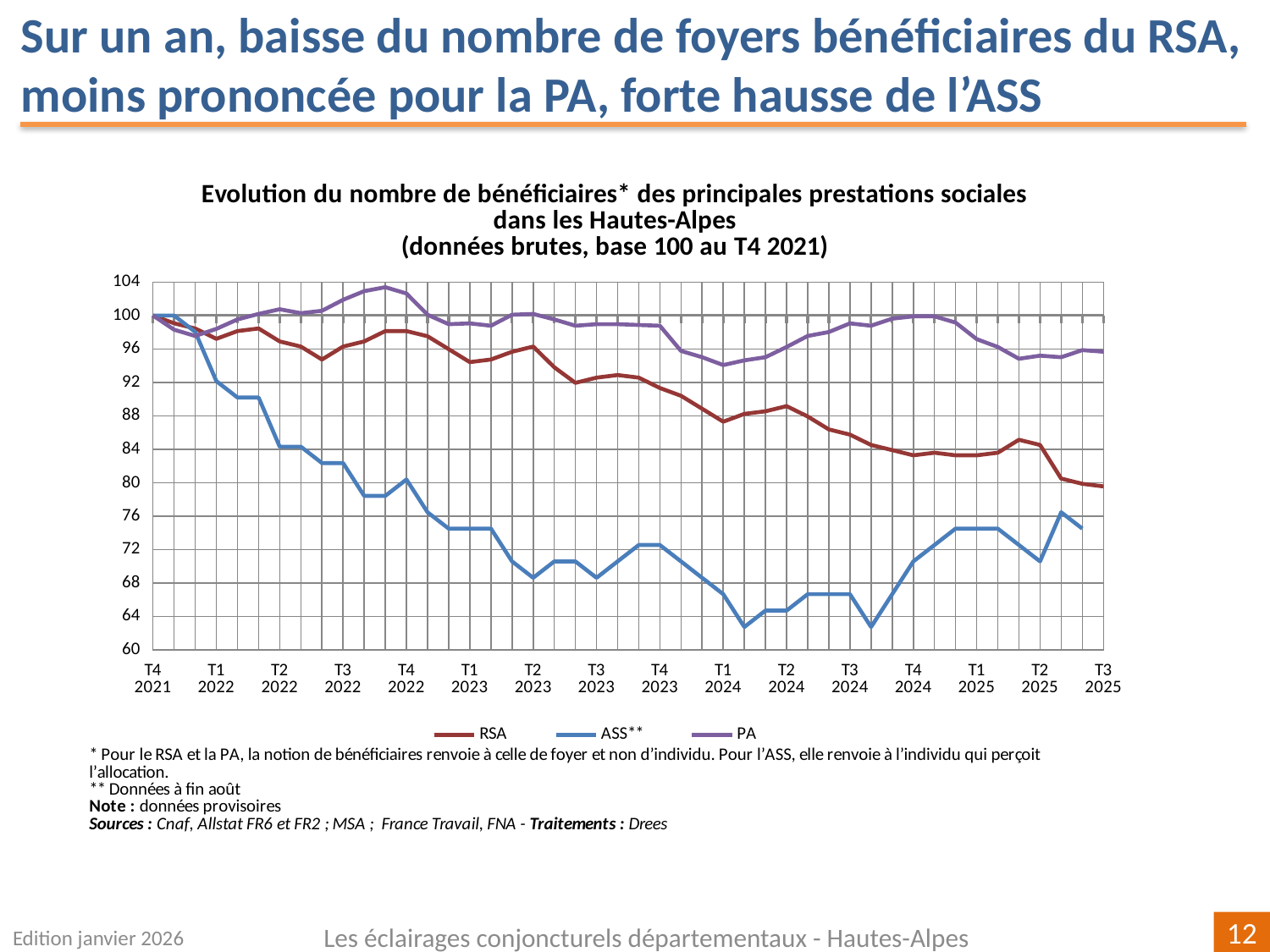
Is the value of the ASS** series at T4 2022 greater or less than 76? greater Does the RSA series rise or fall overall from T4 2021 to T3 2025? fall How many series does the legend list? 3 Is the value of the RSA series at T3 2025 greater or less than 84? less What is the base period of the index used in the chart? T4 2021 What kind of chart is shown on the slide? line chart What is the value of the RSA series at T4 2021? 100 Is the value of the PA series at T4 2022 greater or less than 100? greater At T3 2025, which series has the higher value, PA or RSA? PA How many quarter labels are shown on the x axis? 16